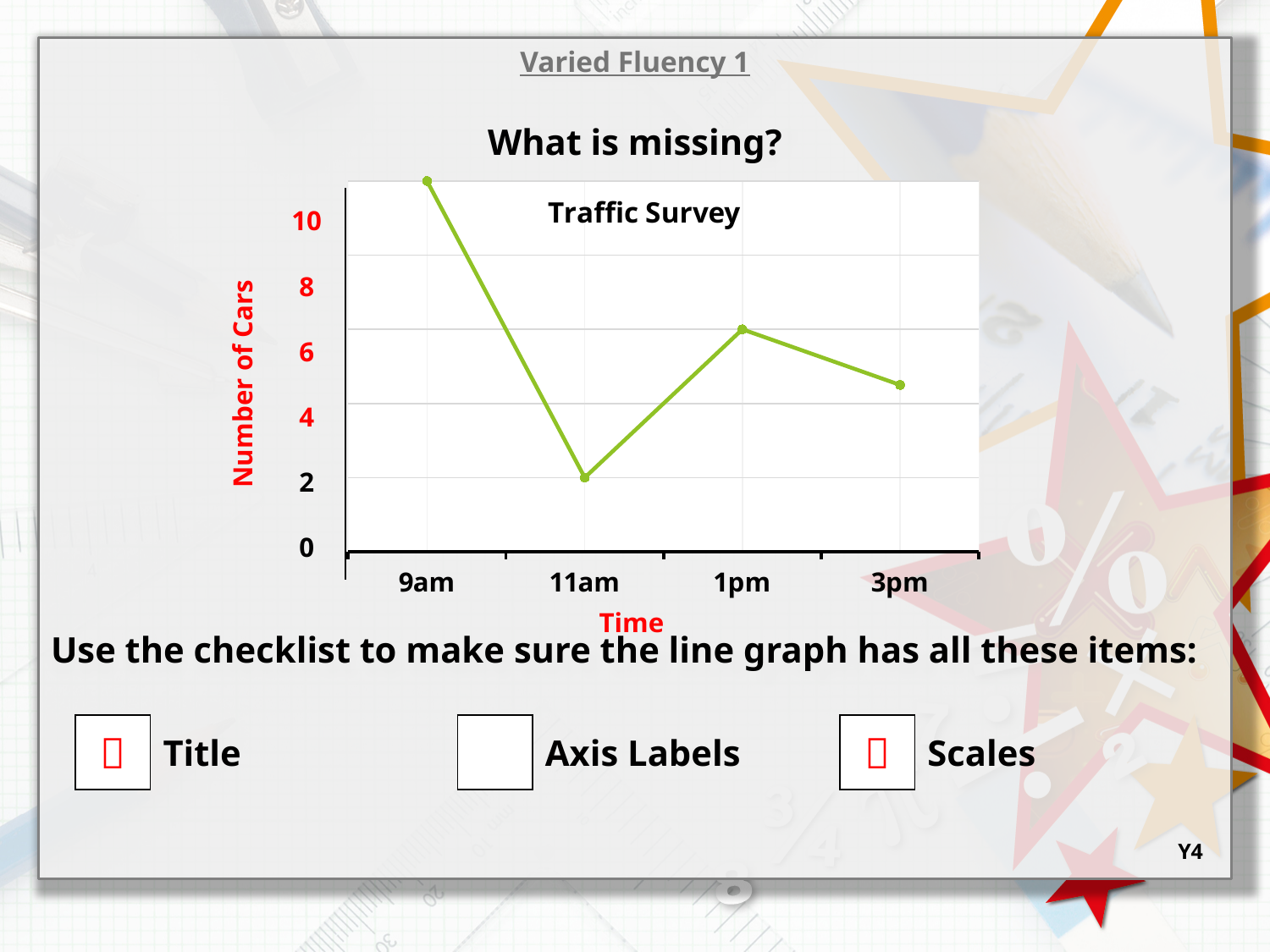
How many time points are plotted on the Traffic Survey chart? 4 What kind of chart is shown on the slide? line chart At which time is the number of cars highest? 9am Is the number of cars at 3pm greater or less than 6? less What is the label on the vertical axis of the chart? Number of Cars Does the number of cars rise or fall from 9am to 11am? fall Which has more cars, 1pm or 3pm? 1pm What is the number of cars at 11am? 2 At which time is the number of cars lowest? 11am What is the title of the chart? Traffic Survey